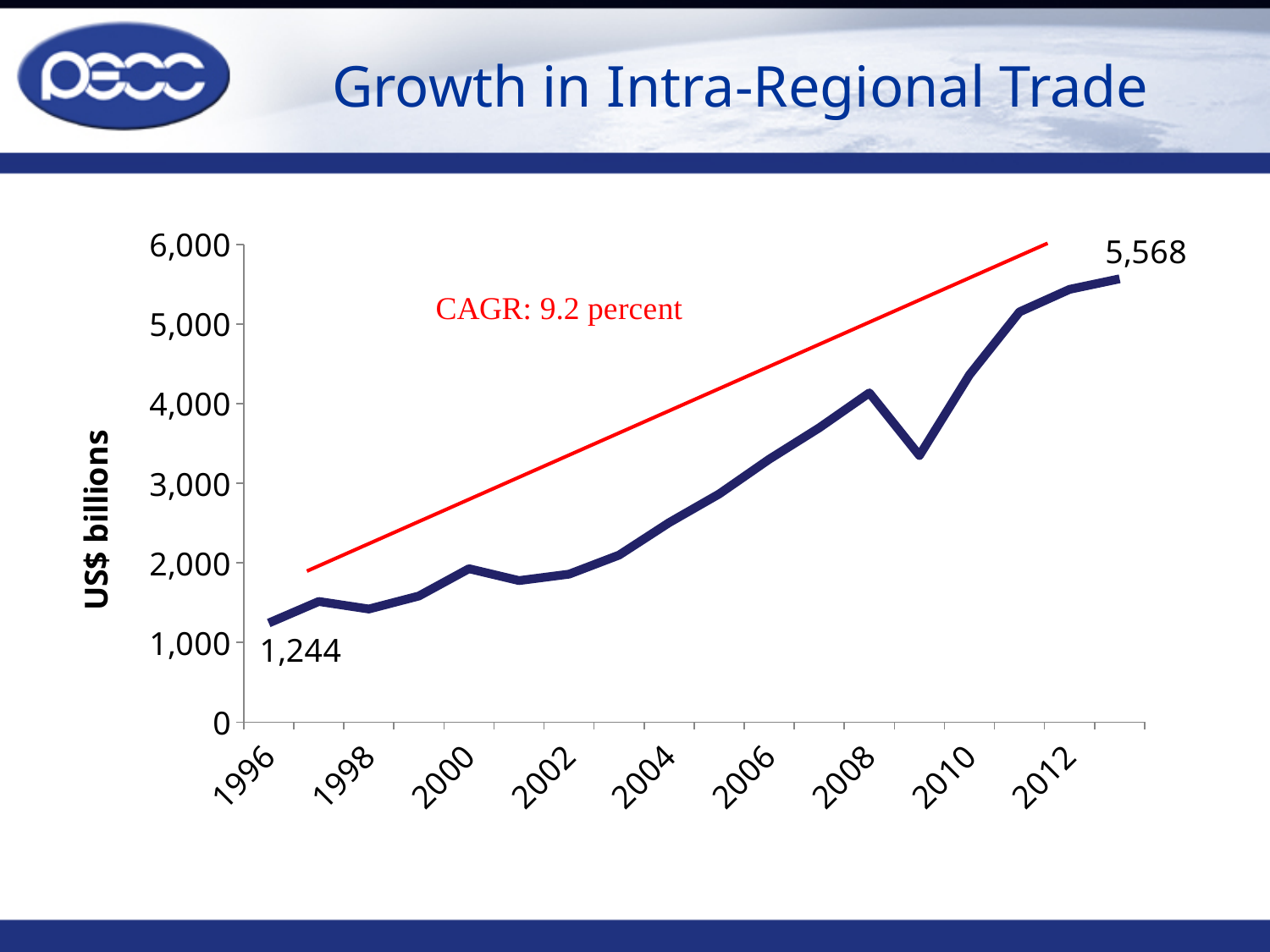
What is the value labelled at the end of the line? 5,568 What is the value of intra-regional trade at the start of the line in 1996? 1,244 Is the value for 2009 greater or less than 4,000? less What is the lowest value labelled on the chart? 1,244 Does intra-regional trade generally rise or fall from 1996 to the end of the series? Rise Which year has the larger value, 2008 or 2009? 2008 Is the value for 2006 greater or less than 3,000? greater What is the highest value labelled on the chart? 5,568 What CAGR is stated on the chart? 9.2 percent What is the label on the vertical axis? US$ billions What kind of chart is shown on the slide? Line chart What is the difference between the final labelled value (5,568) and the initial labelled value (1,244)? 4,324